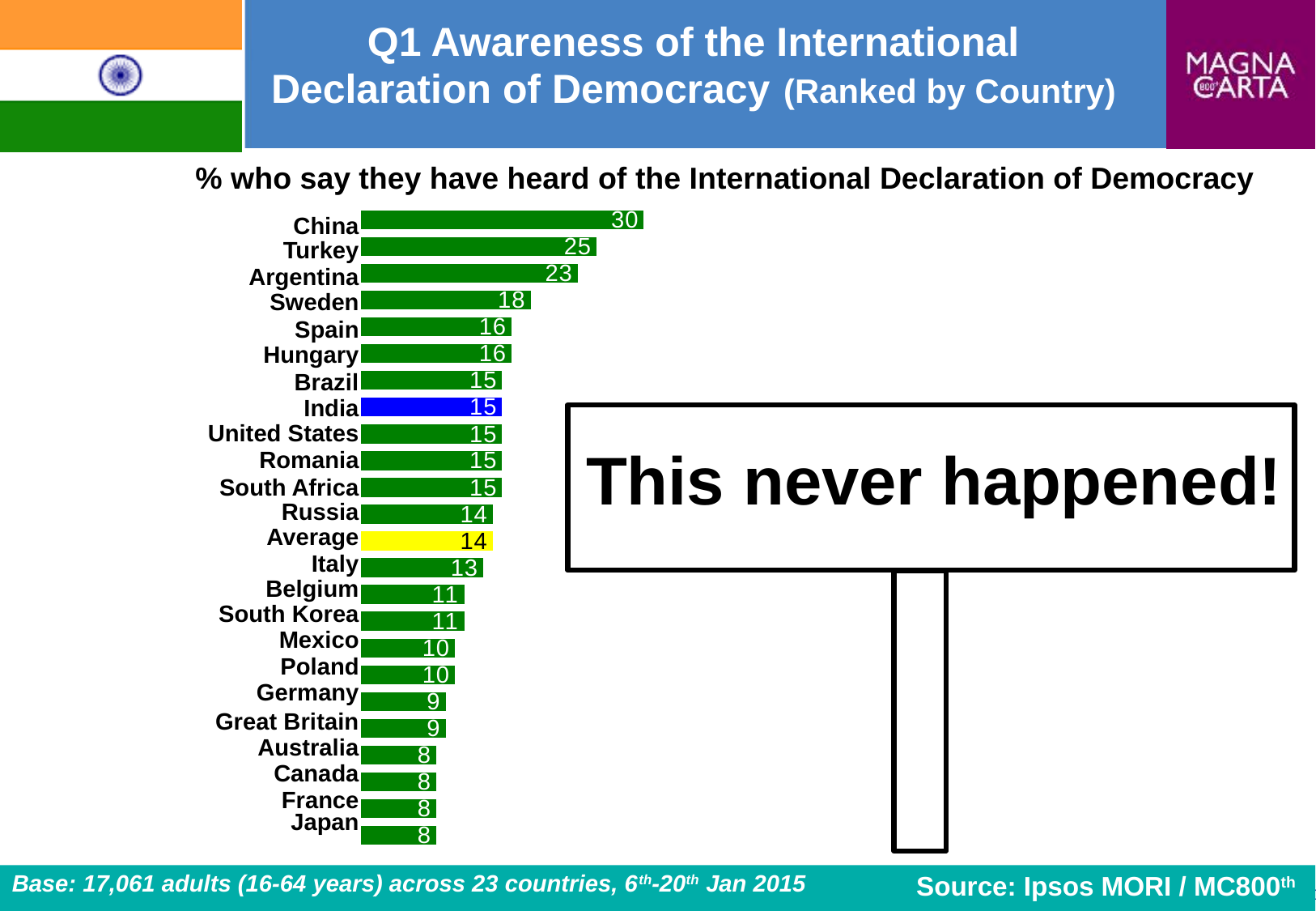
What is the difference between the values for China and Turkey? 5 Which has a larger value, Russia or Germany? Russia Which has a larger value, Argentina or Sweden? Argentina What is the value shown for India? 15 What is the value shown for China? 30 Which country has the highest value in the chart? China What is the difference between the values for Sweden and Italy? 5 How many bars are plotted in the chart, including the Average bar? 24 What colour is the bar for India? Blue What is the value shown for Japan? 8 What type of chart is shown on the slide? Bar chart What is the value shown for the Average bar? 14